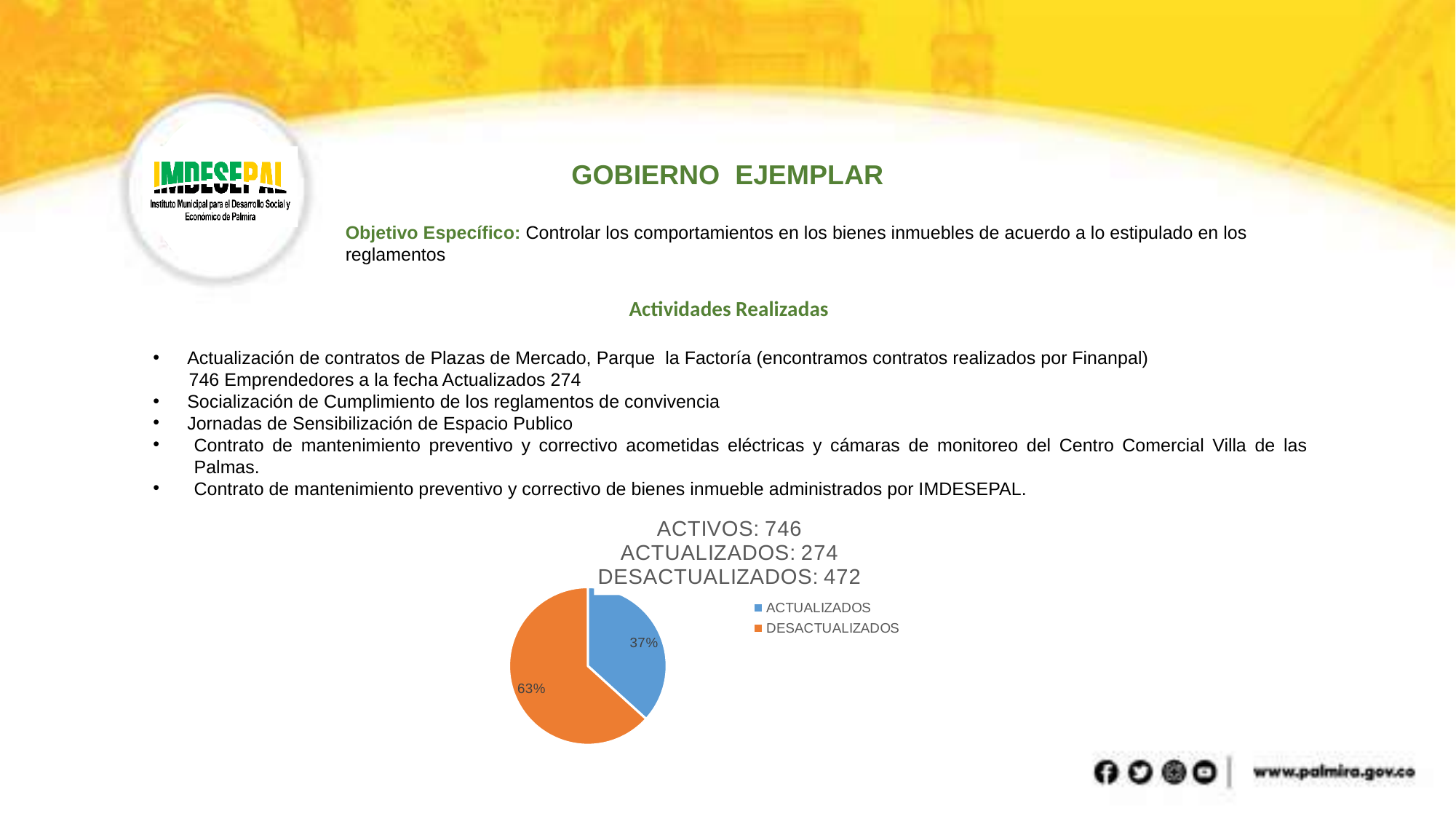
Which slice of the pie chart is the smallest? ACTUALIZADOS How many entries does the legend of the pie chart list? 2 What share of the pie does DESACTUALIZADOS represent? 63% What share of the pie does ACTUALIZADOS represent? 37% According to the chart title, how many ACTIVOS are there? 746 What is the difference in percentage points between the DESACTUALIZADOS and ACTUALIZADOS slices? 26 percentage points What colour is the ACTUALIZADOS slice in the pie chart? Blue Which slice of the pie chart is the largest? DESACTUALIZADOS Which is larger in the pie chart, ACTUALIZADOS or DESACTUALIZADOS? DESACTUALIZADOS How many slices does the pie chart have? 2 What kind of chart is shown on the slide? Pie chart According to the chart title, how many are DESACTUALIZADOS? 472